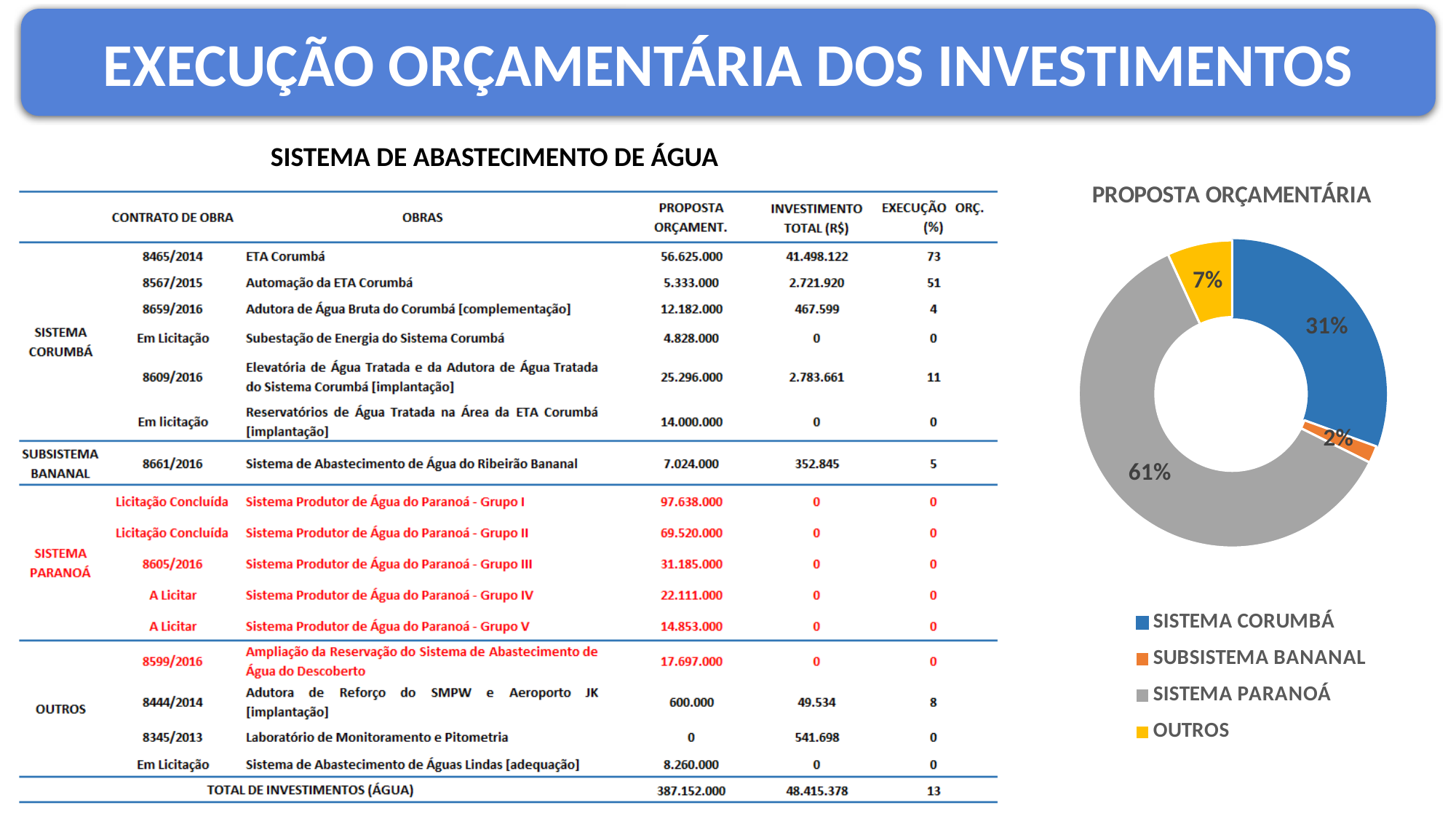
In the PROPOSTA ORÇAMENTÁRIA chart, what share does SISTEMA CORUMBÁ have? 31% What kind of chart is the PROPOSTA ORÇAMENTÁRIA chart? Doughnut chart In the PROPOSTA ORÇAMENTÁRIA chart, what share does SISTEMA PARANOÁ have? 61% In the PROPOSTA ORÇAMENTÁRIA chart, which category has the largest share? SISTEMA PARANOÁ How many categories does the legend of the PROPOSTA ORÇAMENTÁRIA chart list? 4 In the PROPOSTA ORÇAMENTÁRIA chart, which is larger: OUTROS or SUBSISTEMA BANANAL? OUTROS What is the title of the doughnut chart on the slide? PROPOSTA ORÇAMENTÁRIA In the PROPOSTA ORÇAMENTÁRIA chart, what share does SUBSISTEMA BANANAL have? 2% In the PROPOSTA ORÇAMENTÁRIA chart, which category has the smallest share? SUBSISTEMA BANANAL In the PROPOSTA ORÇAMENTÁRIA chart, what is the difference in percentage points between SISTEMA PARANOÁ and SISTEMA CORUMBÁ? 30 In the PROPOSTA ORÇAMENTÁRIA chart, what colour is the SISTEMA PARANOÁ slice? Grey In the PROPOSTA ORÇAMENTÁRIA chart, what share does OUTROS have? 7%